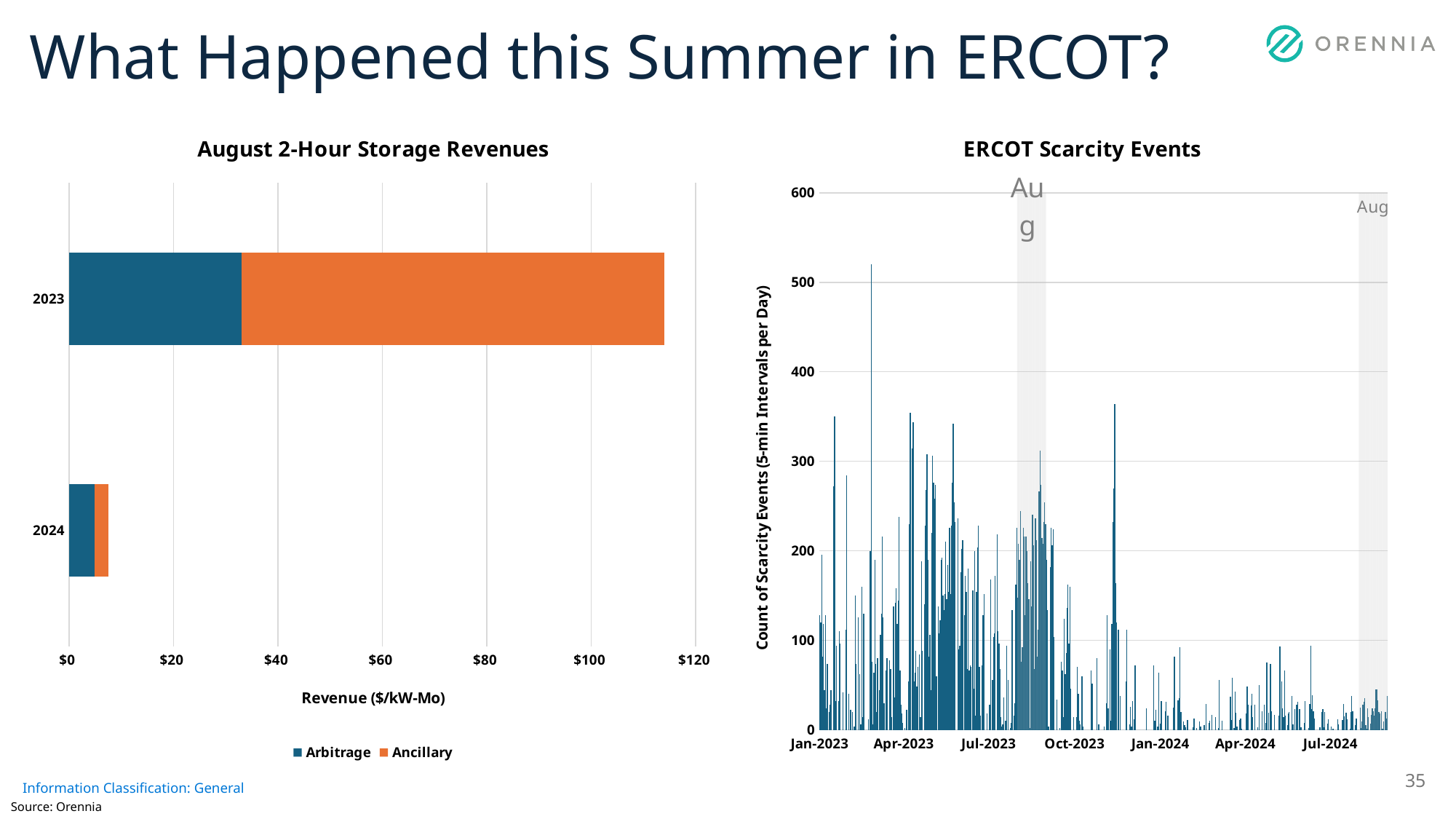
In the 'August 2-Hour Storage Revenues' chart, is the total revenue for 2023 greater or less than $100? greater How many series does the legend of the 'August 2-Hour Storage Revenues' chart list? 2 What is the y-axis label of the 'ERCOT Scarcity Events' chart? Count of Scarcity Events (5-min Intervals per Day) In the 'August 2-Hour Storage Revenues' chart, is the Arbitrage revenue for 2023 greater or less than $40? less In the 'August 2-Hour Storage Revenues' chart, which series contributes more to the 2023 bar, Arbitrage or Ancillary? Ancillary In the 'ERCOT Scarcity Events' chart, is the highest daily value greater or less than 500? greater How many years are shown on the 'August 2-Hour Storage Revenues' chart? 2 In the 'August 2-Hour Storage Revenues' chart, which year has the higher total revenue, 2023 or 2024? 2023 What is the x-axis label of the 'August 2-Hour Storage Revenues' chart? Revenue ($/kW-Mo) In the 'ERCOT Scarcity Events' chart, do the counts of scarcity events generally rise or fall from 2023 to 2024? fall What kind of chart is the 'August 2-Hour Storage Revenues' chart? bar chart